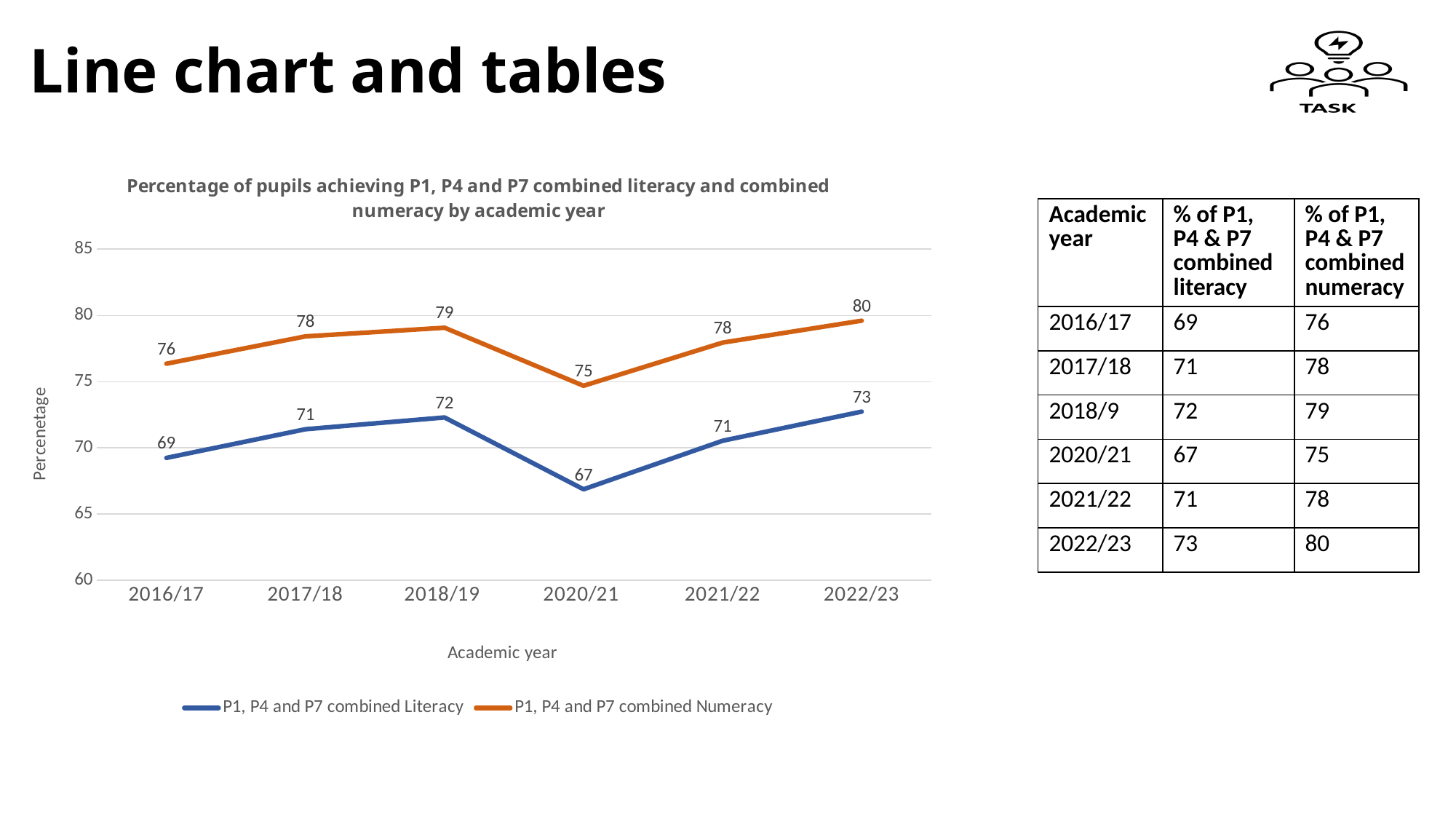
In which academic year is the P1, P4 and P7 combined Numeracy value highest? 2022/23 How many academic years are shown on the x axis of the chart? 6 What is the difference between the combined Numeracy and combined Literacy values in 2018/19? 7 How many series does the chart's legend list? 2 What is the value for P1, P4 and P7 combined Numeracy in 2020/21? 75 Is the value for P1, P4 and P7 combined Literacy in 2020/21 greater or less than 70? less In which academic year is the P1, P4 and P7 combined Literacy value lowest? 2020/21 What is the value for P1, P4 and P7 combined Numeracy in 2022/23? 80 What kind of chart is shown on the slide? line chart Which is larger in 2021/22: the combined Literacy value or the combined Numeracy value? P1, P4 and P7 combined Numeracy Does the P1, P4 and P7 combined Literacy value rise or fall from 2020/21 to 2022/23? rise What is the value for P1, P4 and P7 combined Literacy in 2016/17? 69